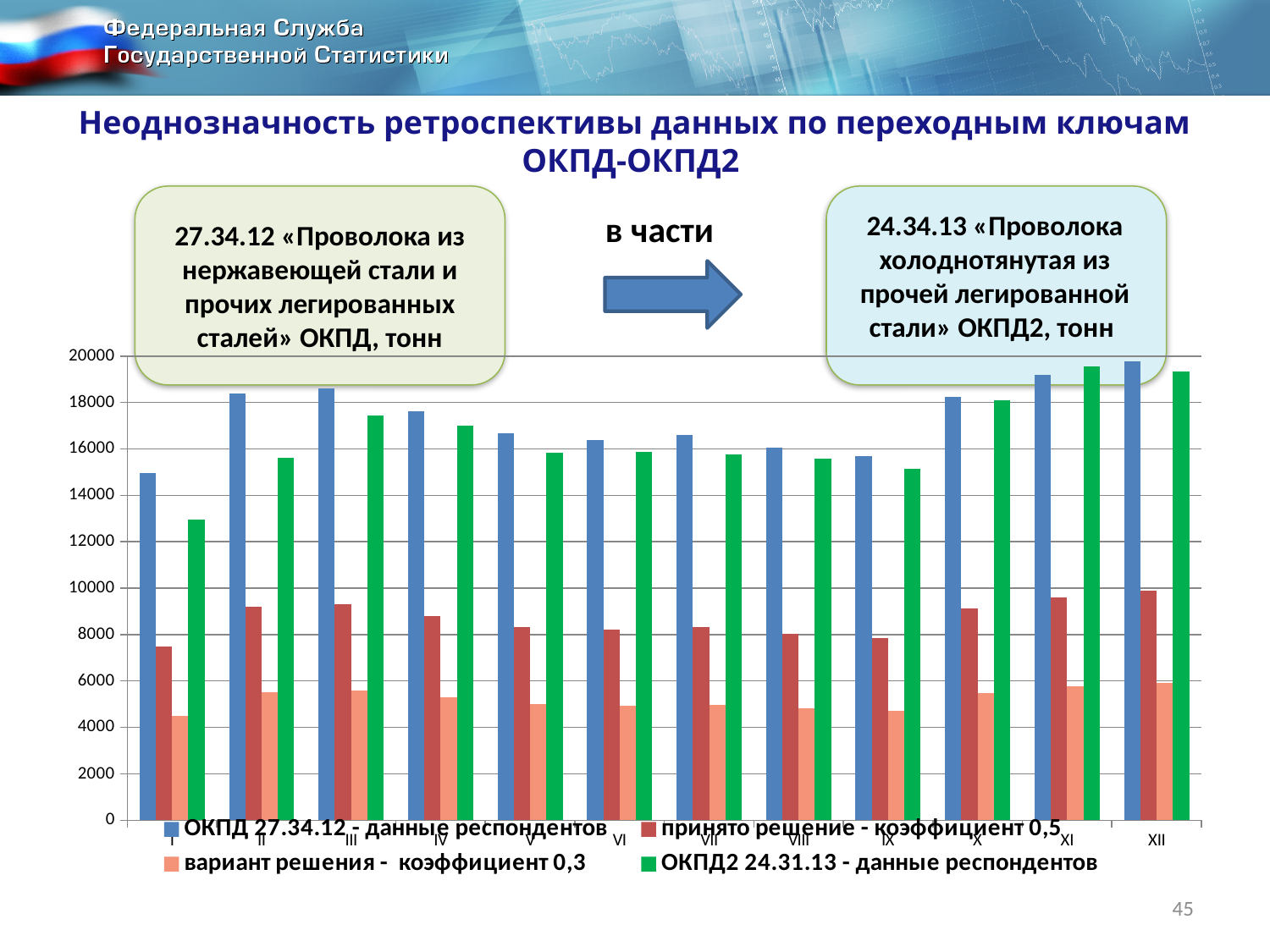
How many categories (months) are shown on the x axis of the chart? 12 Does the series 'ОКПД 27.34.12 - данные респондентов' rise or fall from category VIII to category XII? rise Which category has the highest value for the series 'ОКПД 27.34.12 - данные респондентов'? XII Is the value for 'ОКПД 27.34.12 - данные респондентов' in category I greater or less than 16000? less Which category has the lowest value for the series 'ОКПД2 24.31.13 - данные респондентов'? I Which category has the lowest value for the series 'ОКПД 27.34.12 - данные респондентов'? I What kind of chart is shown on the slide? bar chart Is the value for 'ОКПД2 24.31.13 - данные респондентов' in category I greater or less than 14000? less What colour are the bars for the series 'ОКПД2 24.31.13 - данные респондентов'? green In category III, which is larger: 'ОКПД 27.34.12 - данные респондентов' or 'ОКПД2 24.31.13 - данные респондентов'? ОКПД 27.34.12 - данные респондентов Is the value for 'принято решение - коэффициент 0,5' in category II greater or less than 8000? greater How many series does the chart legend list? 4